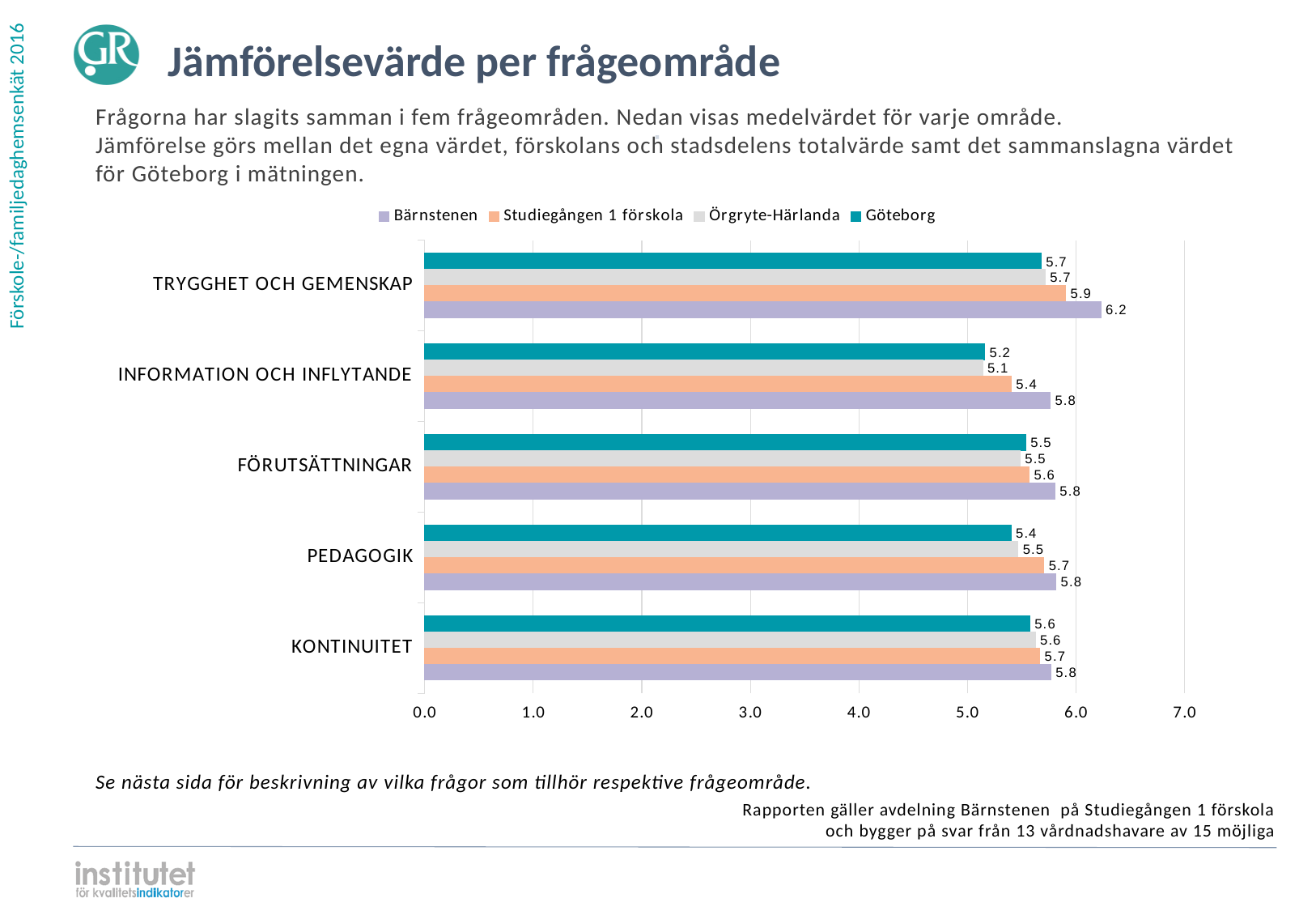
What is the value for Studiegången 1 förskola in the KONTINUITET category? 5.7 What is the difference between the Bärnstenen value and the Örgryte-Härlanda value in the INFORMATION OCH INFLYTANDE category? 0.7 In which category does Göteborg have its lowest value? INFORMATION OCH INFLYTANDE Which is larger in the FÖRUTSÄTTNINGAR category: the value for Bärnstenen or the value for Studiegången 1 förskola? Bärnstenen What kind of chart is shown on the slide? Bar chart In which category does Bärnstenen have its highest value? TRYGGHET OCH GEMENSKAP What is the value for Göteborg in the PEDAGOGIK category? 5.4 What is the value for Bärnstenen in the TRYGGHET OCH GEMENSKAP category? 6.2 How many categories (frågeområden) are shown on the chart? 5 Is the value for Bärnstenen in the TRYGGHET OCH GEMENSKAP category greater or less than 6.0? greater How many series does the legend list? 4 What is the value for Örgryte-Härlanda in the INFORMATION OCH INFLYTANDE category? 5.1